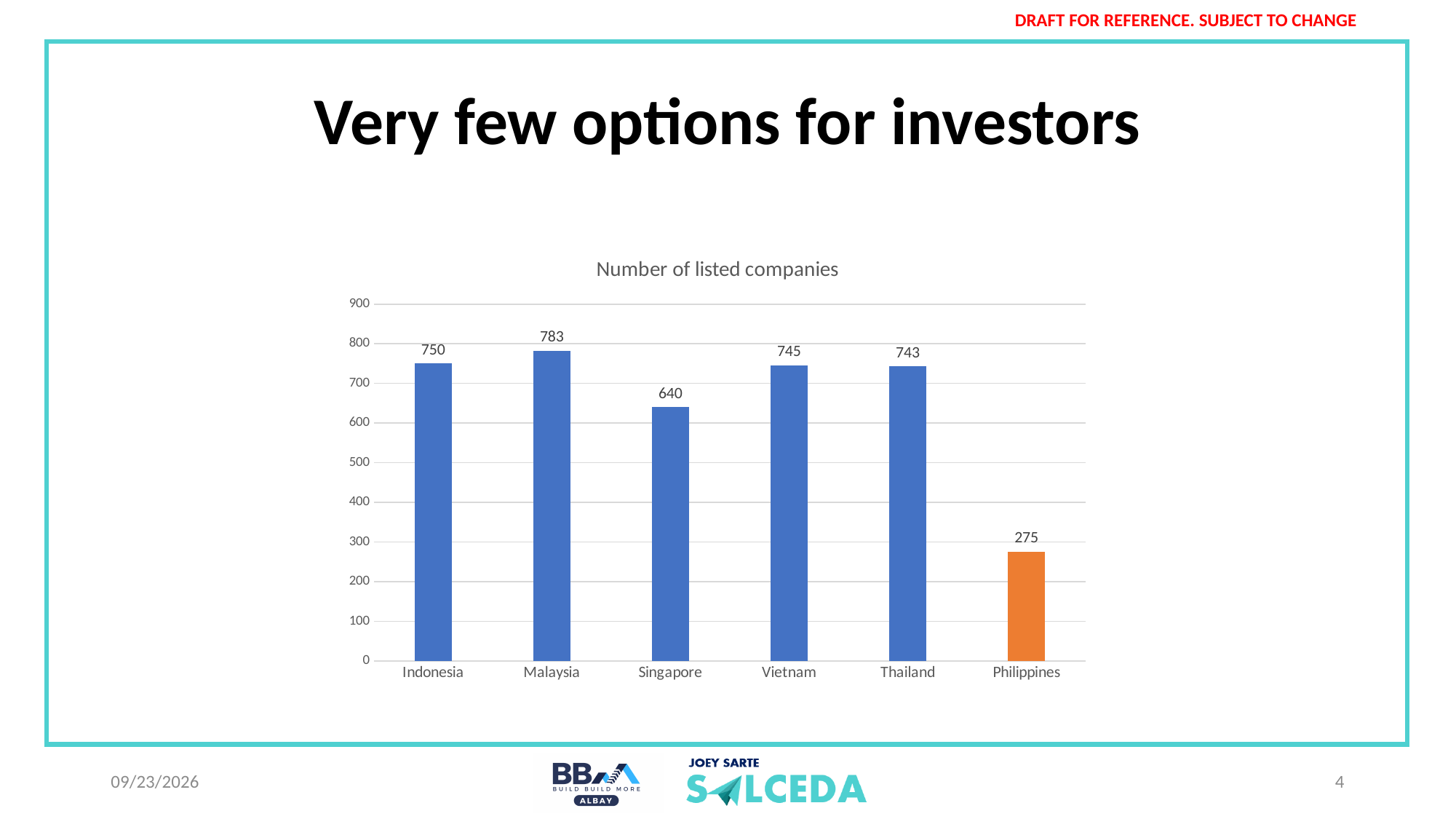
Which country has the highest number of listed companies? Malaysia What is the number of listed companies for the Philippines? 275 What kind of chart is shown on the slide? Bar chart Is the value for Singapore greater or less than 700? less What is the difference between the number of listed companies in Malaysia and the Philippines? 508 What is the number of listed companies for Indonesia? 750 Which has more listed companies, Singapore or Vietnam? Vietnam Which country has the lowest number of listed companies? Philippines What is the number of listed companies for Singapore? 640 How many countries are shown in the chart? 6 What is the difference between the number of listed companies in Indonesia and Singapore? 110 What is the title of the chart? Number of listed companies